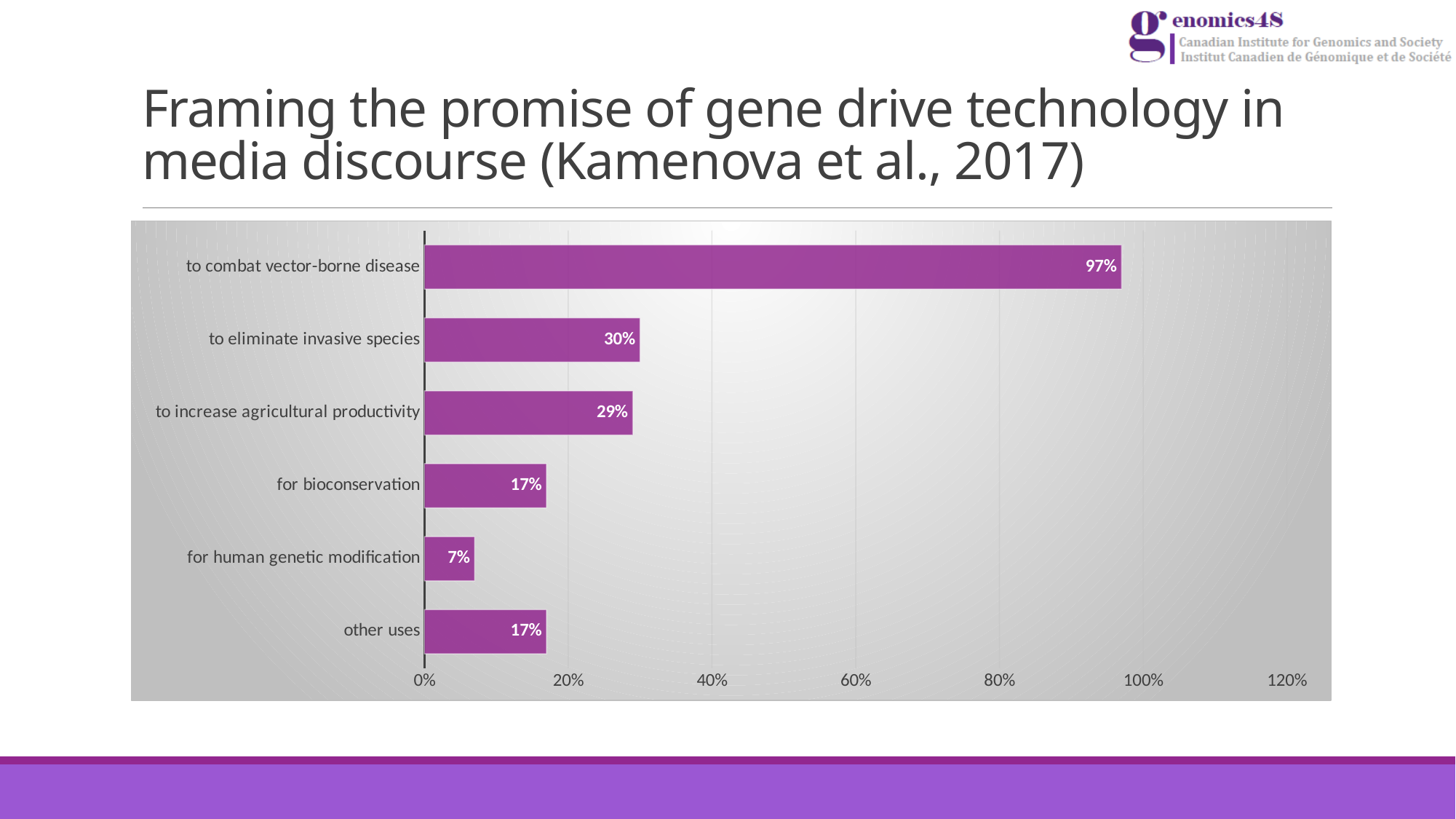
What is the difference between the values for "to combat vector-borne disease" and "to eliminate invasive species"? 67% What is the value for "for bioconservation"? 17% Which is larger, the value for "to eliminate invasive species" or the value for "for bioconservation"? to eliminate invasive species What is the value for "for human genetic modification"? 7% What is the difference between the values for "to increase agricultural productivity" and "for human genetic modification"? 22% How many categories are shown in the chart? 6 What is the value for "to combat vector-borne disease"? 97% What is the value for "to eliminate invasive species"? 30% Which category has the highest value? to combat vector-borne disease What is the highest value shown on the x axis? 120% What kind of chart is shown on the slide? bar chart Which category has the lowest value? for human genetic modification